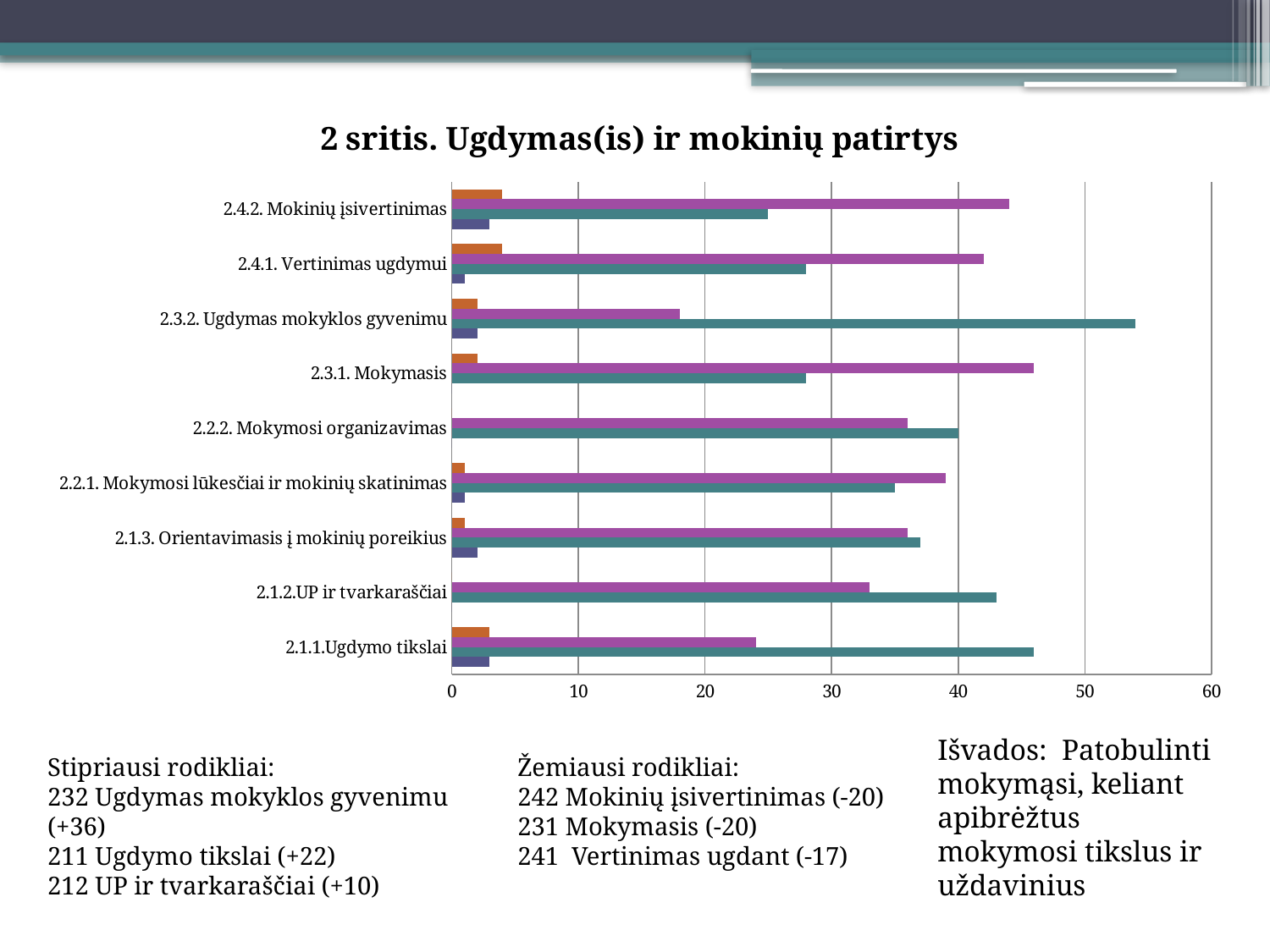
Is the teal bar for 2.3.2. Ugdymas mokyklos gyvenimu greater or less than 50? greater For 2.1.1.Ugdymo tikslai, which bar is longer, the teal bar or the purple bar? the teal bar For 2.4.2. Mokinių įsivertinimas, which bar is longer, the purple bar or the teal bar? the purple bar Is the purple bar for 2.3.2. Ugdymas mokyklos gyvenimu greater or less than 20? less Is the teal bar for 2.1.2.UP ir tvarkaraščiai greater or less than 40? greater Which category has the longest teal bar? 2.3.2. Ugdymas mokyklos gyvenimu What is the highest value shown on the horizontal axis of the chart? 60 What is the title of the chart? 2 sritis. Ugdymas(is) ir mokinių patirtys What kind of chart is shown on the slide? bar chart How many categories are listed on the vertical axis of the chart? 9 Which category has the shortest purple bar? 2.3.2. Ugdymas mokyklos gyvenimu